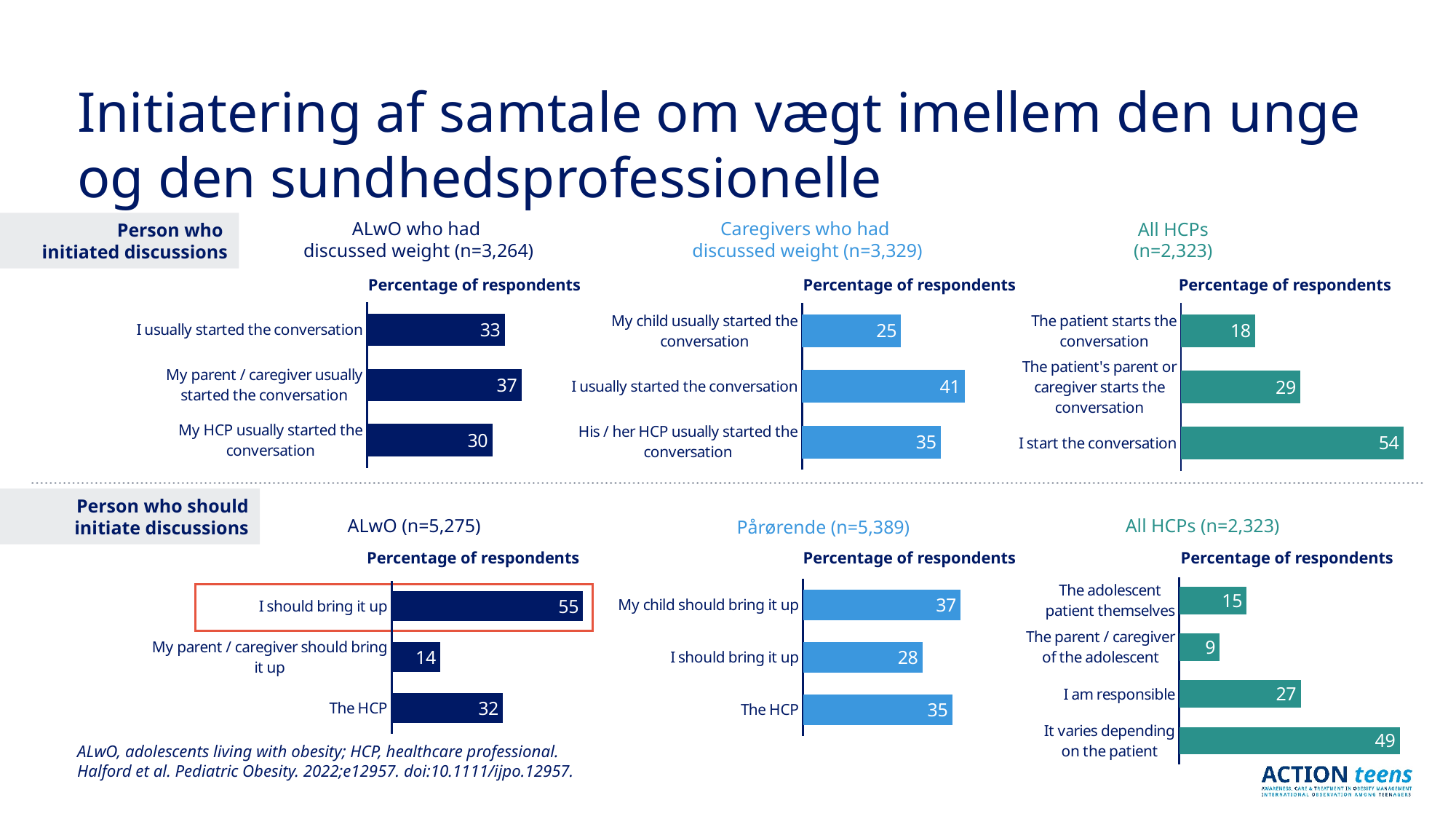
In the 'ALwO (n=5,275)' chart, what is the value for 'I should bring it up'? 55 In the 'Caregivers who had discussed weight (n=3,329)' chart, which category has the highest value? I usually started the conversation In the 'ALwO who had discussed weight (n=3,264)' chart, what percentage of respondents said 'My parent / caregiver usually started the conversation'? 37 In the 'Pårørende (n=5,389)' chart, what is the value for 'I should bring it up'? 28 In the top-right 'All HCPs (n=2,323)' chart, what is the value for 'I start the conversation'? 54 In the bottom-right 'All HCPs (n=2,323)' chart, how many categories are shown? 4 In the 'Pårørende (n=5,389)' chart, which is larger: 'My child should bring it up' or 'The HCP'? My child should bring it up In the 'ALwO who had discussed weight (n=3,264)' chart, what is the difference between 'I usually started the conversation' and 'My HCP usually started the conversation'? 3 In the bottom-right 'All HCPs (n=2,323)' chart, what is the value for 'It varies depending on the patient'? 49 In the top-right 'All HCPs (n=2,323)' chart, what is the difference between 'I start the conversation' and 'The patient starts the conversation'? 36 What type of chart is the 'ALwO who had discussed weight (n=3,264)' chart? Bar chart In the 'ALwO (n=5,275)' chart, which category has the lowest value? My parent / caregiver should bring it up